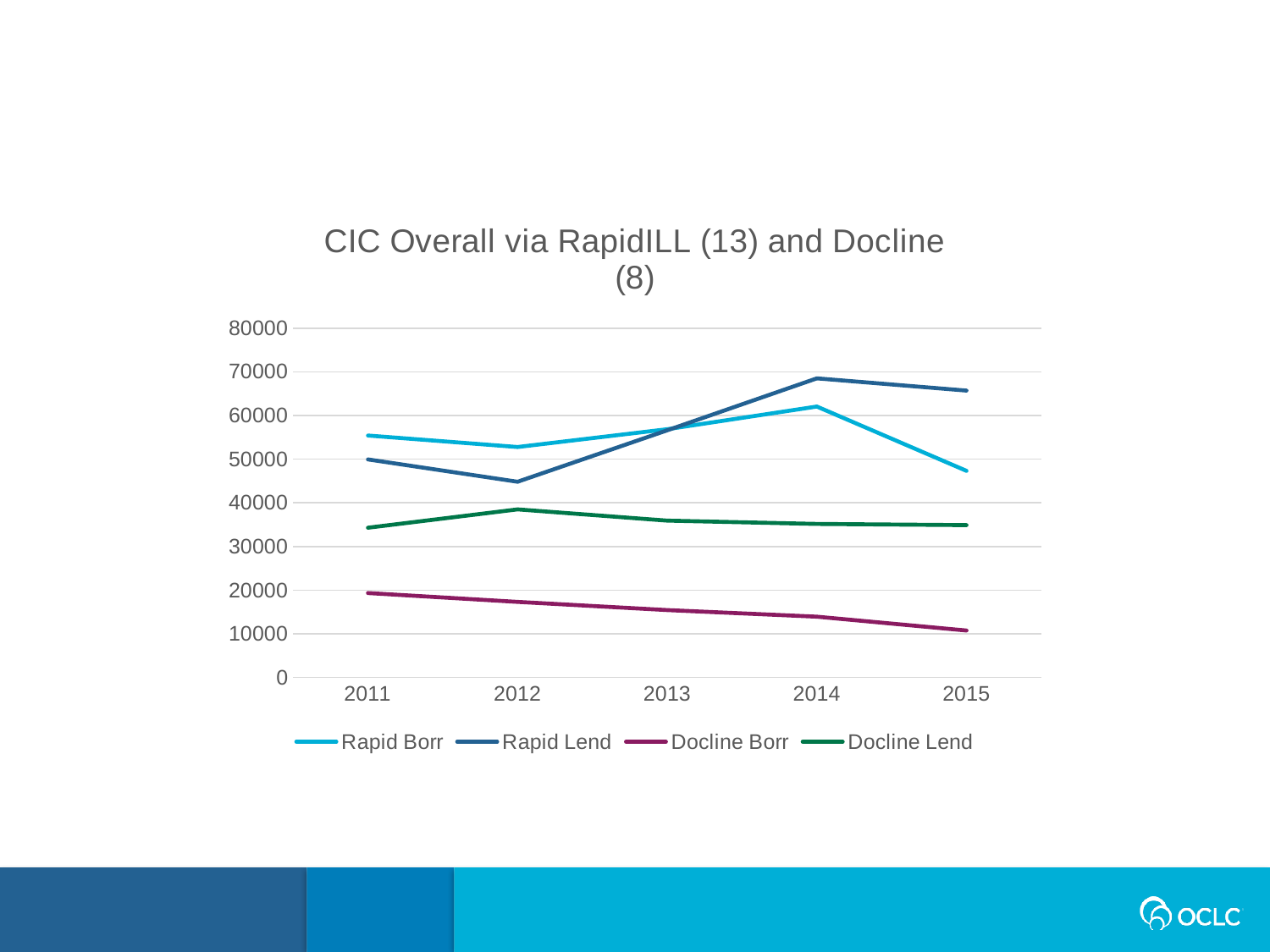
Is the value for Rapid Borr in 2015 greater or less than 50000? less What kind of chart is shown on the slide? Line chart In 2015, which is larger: Rapid Lend or Rapid Borr? Rapid Lend Is the value for Docline Lend in 2012 greater or less than 40000? less Does the Docline Borr series rise or fall from 2011 to 2015? Fall What is the title of the chart? CIC Overall via RapidILL (13) and Docline (8) In which year does the Rapid Lend series reach its highest value? 2014 How many years are shown on the x axis? 5 How many series does the legend list? 4 In which year is the Docline Borr series at its lowest? 2015 In 2012, which is larger: Rapid Borr or Rapid Lend? Rapid Borr Is the value for Rapid Lend in 2014 greater or less than 60000? greater